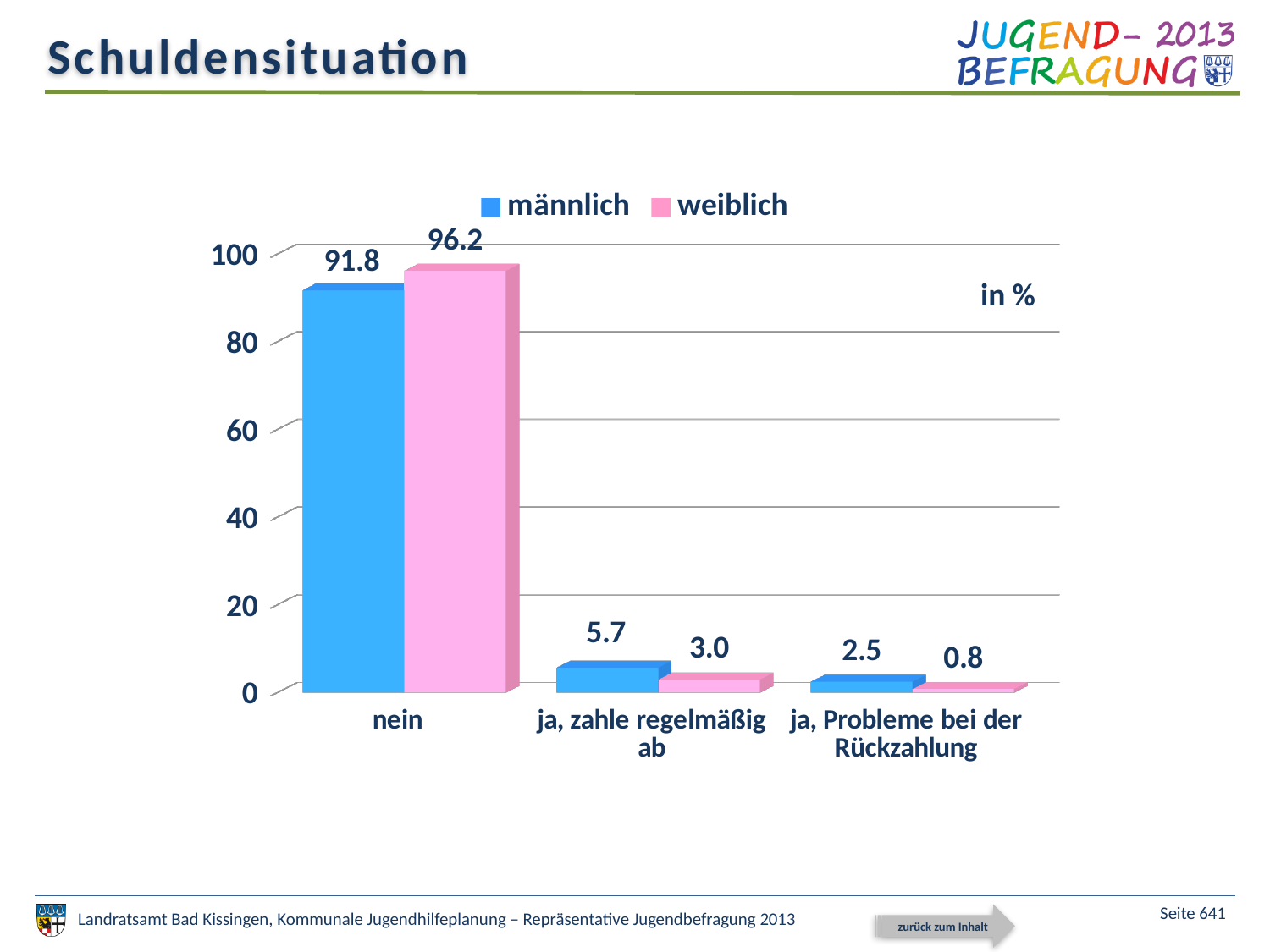
What is the value for weiblich in the category "ja, Probleme bei der Rückzahlung"? 0.8 In the category "ja, zahle regelmäßig ab", which series has the larger value, männlich or weiblich? männlich What is the value for männlich in the category "ja, zahle regelmäßig ab"? 5.7 What is the value for weiblich in the category "nein"? 96.2 What is the difference between the weiblich and männlich values in the category "nein"? 4.4 How many series does the legend list? 2 Which category has the highest value for weiblich? nein How many categories are shown on the x axis? 3 What is the value for männlich in the category "nein"? 91.8 Is the value for männlich in the category "nein" greater or less than 80? greater What kind of chart is shown on the slide? bar chart Which category has the lowest value for männlich? ja, Probleme bei der Rückzahlung